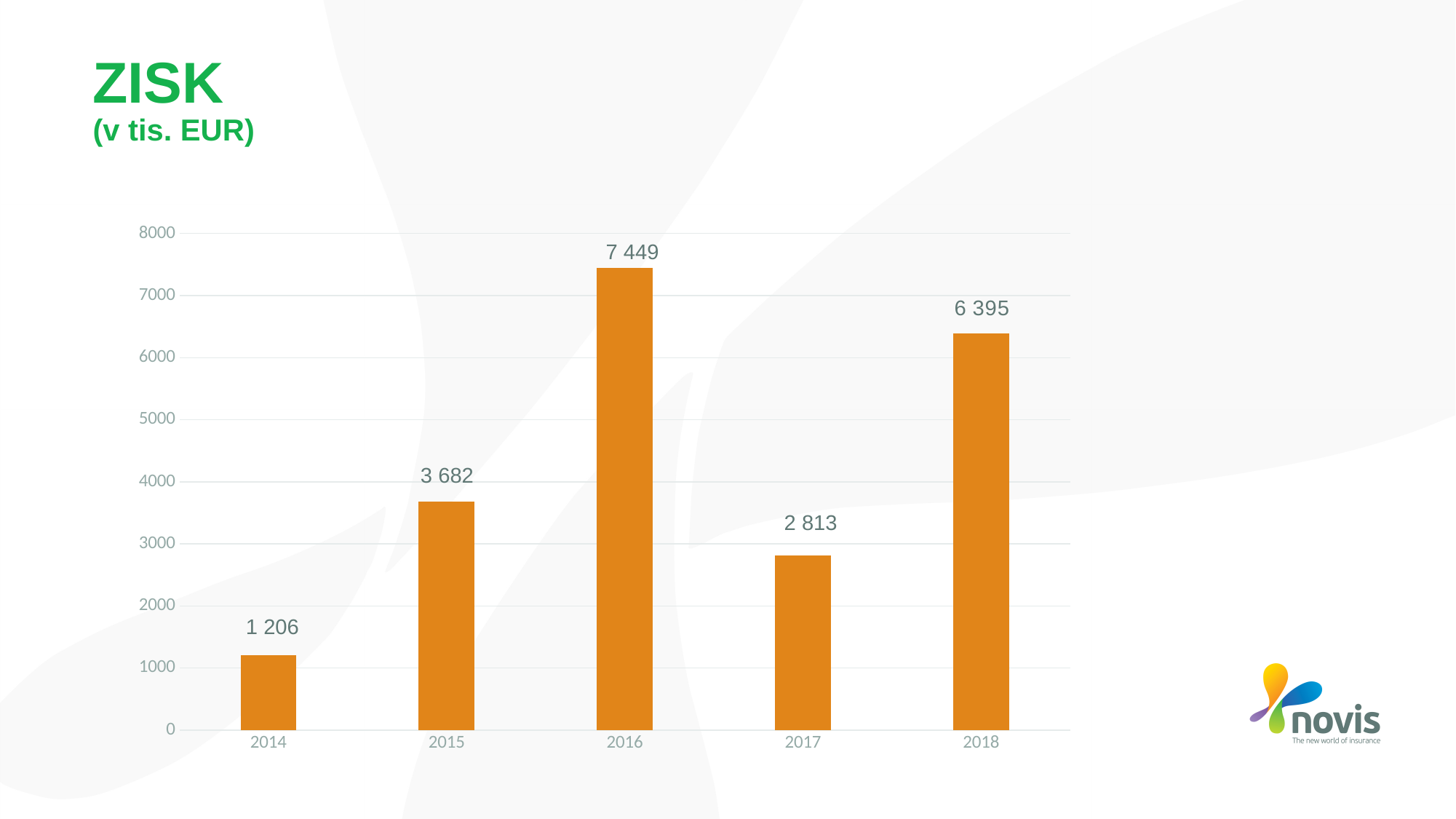
What is the difference between the values for 2015 and 2014? 2 476 Which year has the highest value? 2016 What is the value for 2014? 1 206 Which is larger, the value for 2015 or the value for 2017? 2015 How many years are shown on the x axis? 5 What is the difference between the values for 2016 and 2017? 4 636 Which year has the lowest value? 2014 Is the value for 2018 greater or less than 6000? greater What kind of chart is shown on the slide? bar chart What unit is given in the chart's subtitle? v tis. EUR What is the value for 2016? 7 449 What is the value for 2018? 6 395